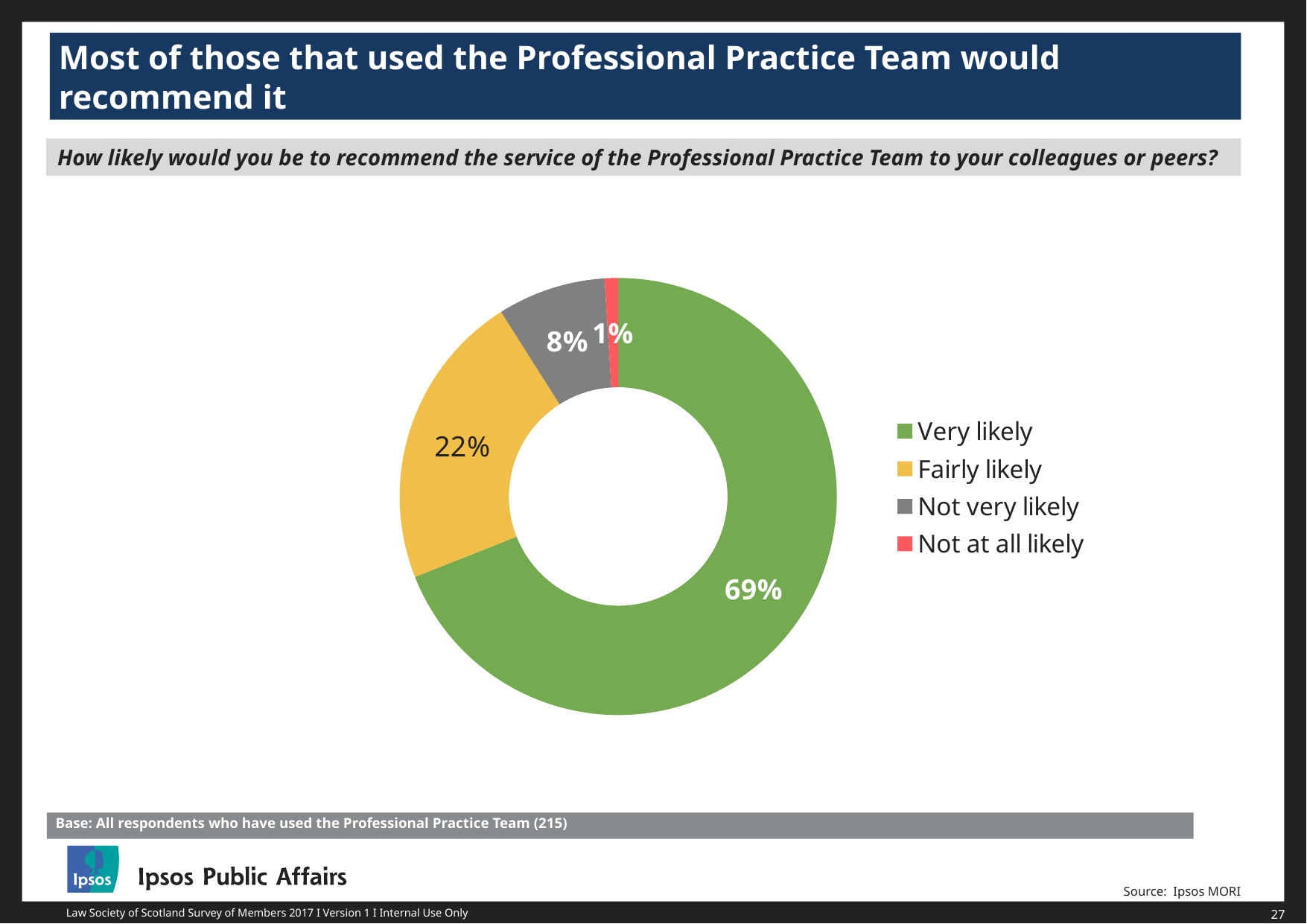
How many response categories are shown in the chart? 4 What percentage of respondents said they would be not at all likely to recommend the service? 1% What percentage of respondents said they would be not very likely to recommend the service? 8% What colour represents the 'Fairly likely' category in the chart? Yellow What is the combined share of respondents who said 'Very likely' or 'Fairly likely'? 91% Which is larger, the share for 'Not very likely' or the share for 'Not at all likely'? Not very likely What kind of chart is shown on the slide? Pie chart (doughnut) What percentage of respondents said they would be very likely to recommend the service of the Professional Practice Team? 69% Which response category has the largest share of the chart? Very likely What percentage of respondents said they would be fairly likely to recommend the service? 22% What is the difference in percentage points between the 'Very likely' and 'Fairly likely' shares? 47 Which response category has the smallest share of the chart? Not at all likely